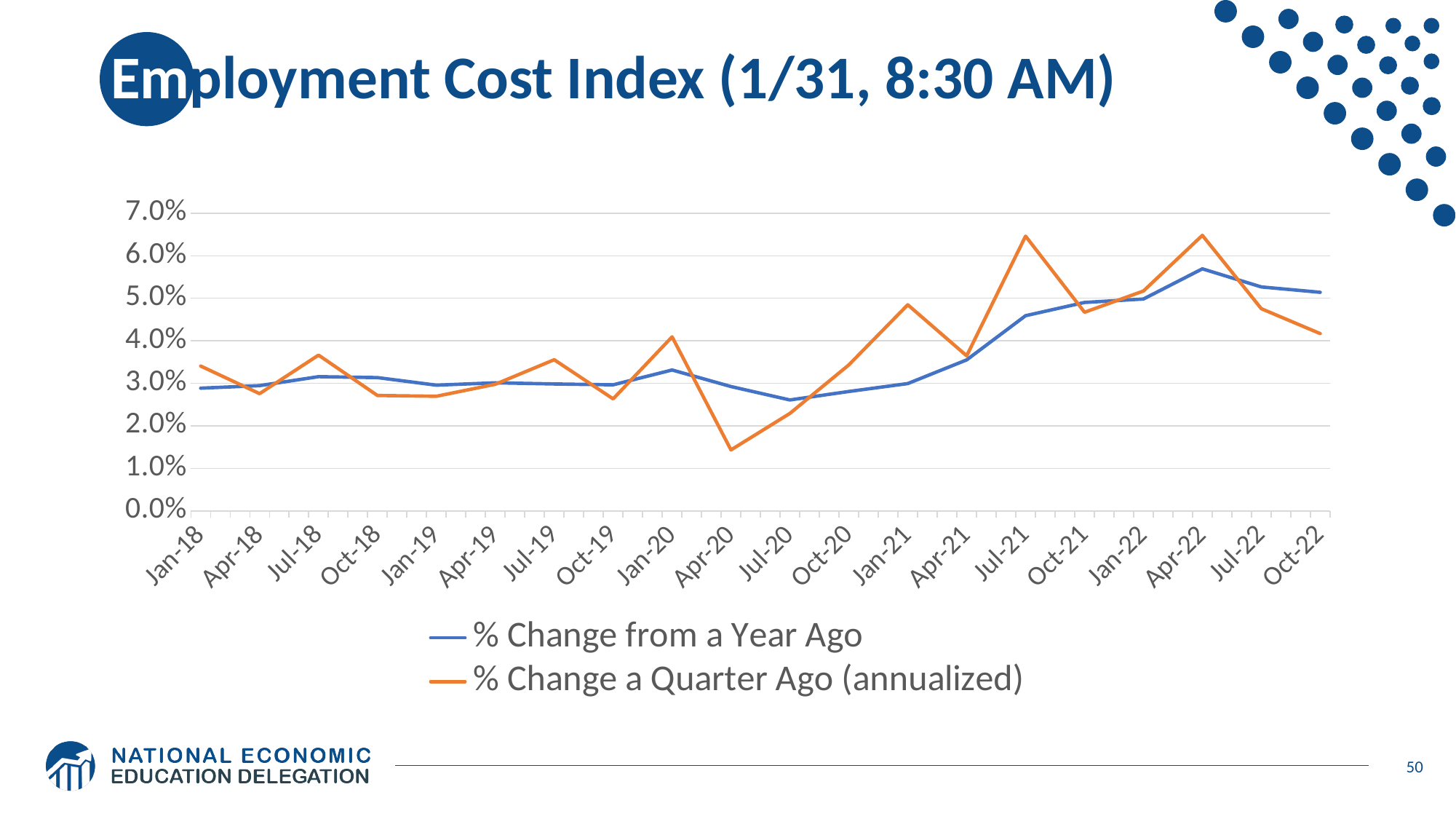
Which series is drawn in orange? % Change a Quarter Ago (annualized) Is the value for % Change a Quarter Ago (annualized) at Apr-20 greater or less than 2.0%? less How many series does the legend list? 2 How many dates are labelled on the x axis? 20 Does the % Change from a Year Ago series rise or fall between Jan-21 and Apr-22? rise At Oct-22, which series has the larger value, % Change from a Year Ago or % Change a Quarter Ago (annualized)? % Change from a Year Ago At which date does the % Change a Quarter Ago (annualized) series reach its lowest value? Apr-20 Is the value for % Change a Quarter Ago (annualized) at Jul-21 greater or less than 6.0%? greater Is the value for % Change from a Year Ago at Apr-22 greater or less than 5.0%? greater What kind of chart is shown on the slide? line chart At which date does the % Change from a Year Ago series reach its highest value? Apr-22 At Jul-21, which series has the larger value, % Change from a Year Ago or % Change a Quarter Ago (annualized)? % Change a Quarter Ago (annualized)